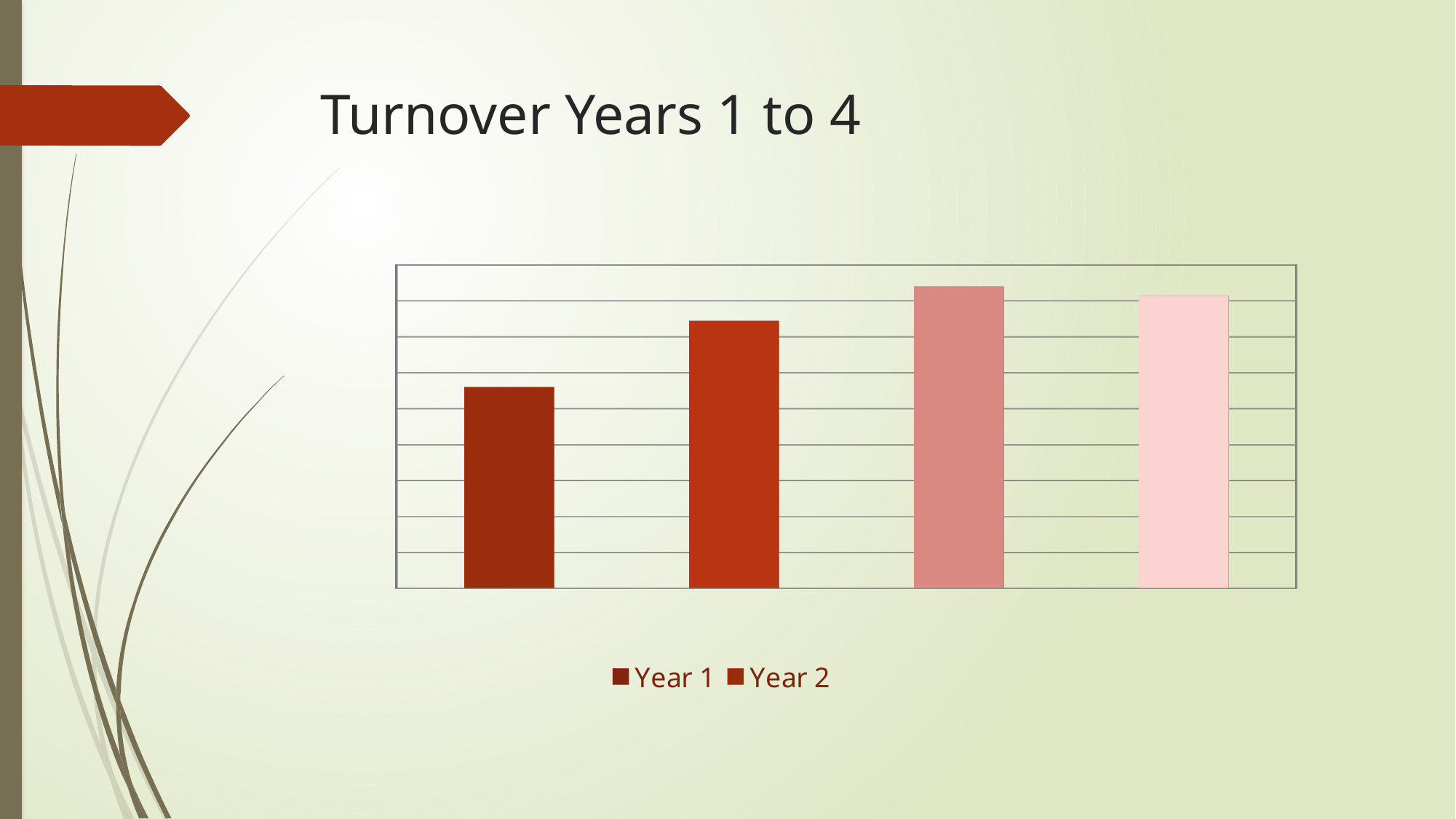
Which of the legend entries, Year 1 or Year 2, has the lowest bar in the chart? Year 1 What kind of chart is shown on the slide? bar chart How many bars are plotted in the chart? 4 Do the bar values rise or fall from the first bar to the third bar? rise What are the two entries shown in the chart legend? Year 1 and Year 2 How many series does the chart legend list? 2 Which bar in the chart is the tallest, counting from the left? the third bar Which is larger, the Year 1 bar or the Year 2 bar? Year 2 What is the title of the slide containing the chart? Turnover Years 1 to 4 Which bar in the chart is the shortest, counting from the left? the first bar